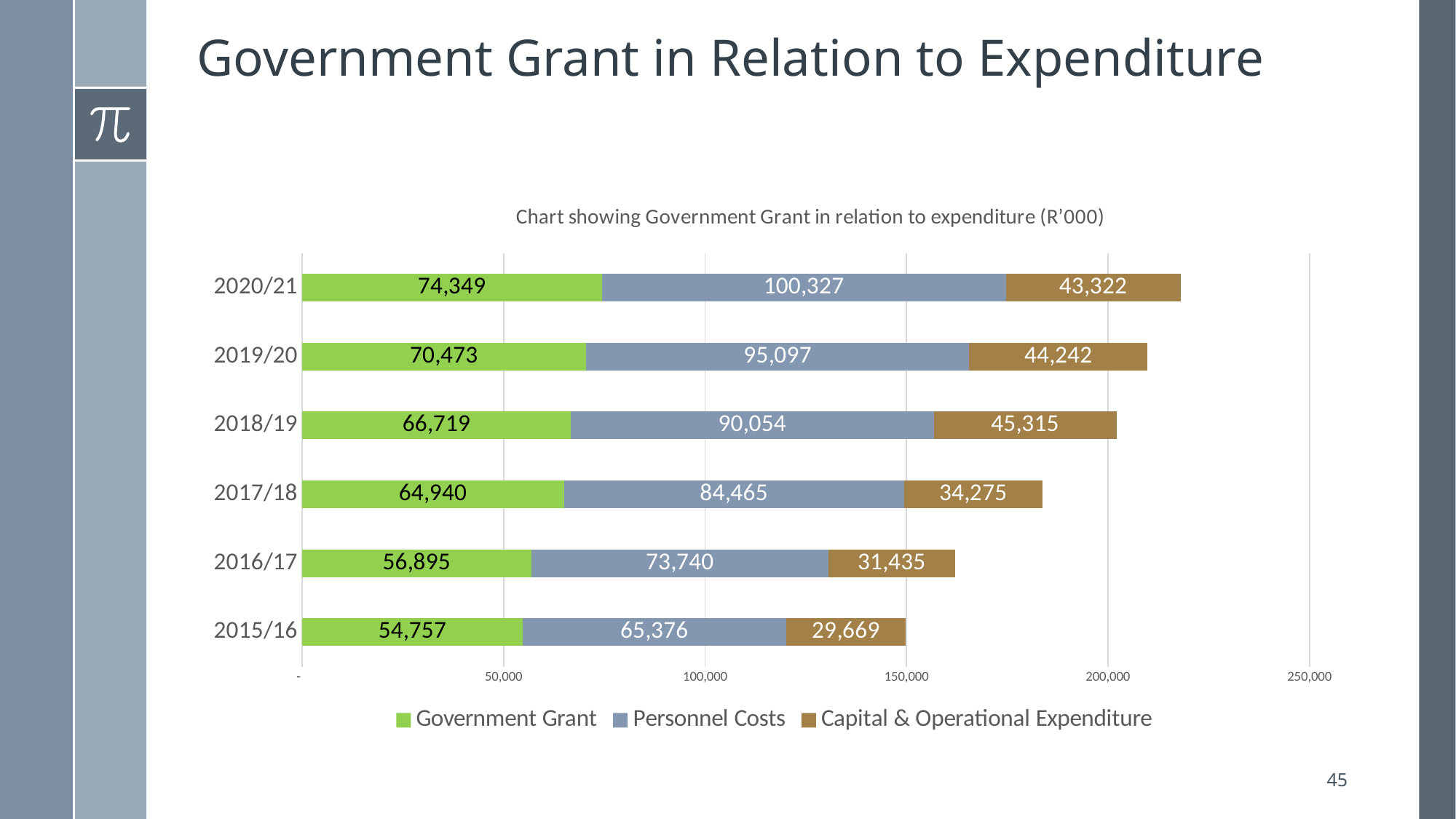
What is the Capital & Operational Expenditure value for 2016/17? 31,435 What kind of chart is shown on the slide? Stacked bar chart What is the total of the stacked bar for 2020/21? 217,998 How many series does the legend list? 3 What is the Personnel Costs value for 2017/18? 84,465 Which is larger: the Government Grant in 2019/20 or the Capital & Operational Expenditure in 2019/20? Government Grant in 2019/20 What is the difference between Personnel Costs in 2020/21 and 2015/16? 34,951 What is the Government Grant value for 2020/21? 74,349 How many years are shown on the chart? 6 Which year has the lowest Government Grant? 2015/16 What is the total of the stacked bar for 2015/16? 149,802 Which year has the highest Capital & Operational Expenditure? 2018/19